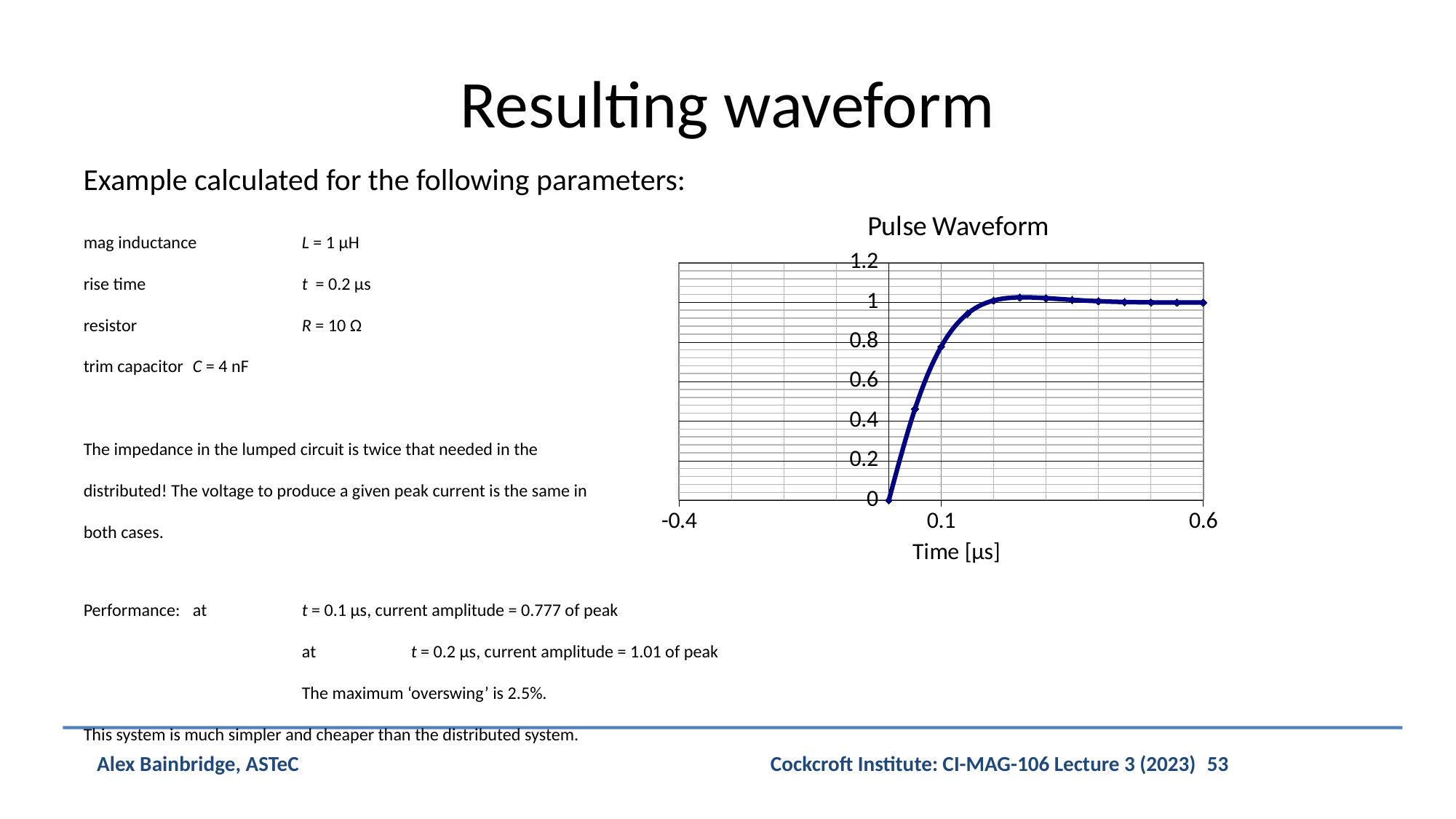
In the Pulse Waveform chart, is the value at 0.6 μs greater or less than 1.2? less What is the title of the chart on the slide? Pulse Waveform What is the highest tick value shown on the y axis of the Pulse Waveform chart? 1.2 In the Pulse Waveform chart, does the curve rise or fall between time 0 and 0.1 μs? rise In the Pulse Waveform chart, is the value at 0.1 μs greater or less than 0.6? greater What is the lowest tick value shown on the x axis of the Pulse Waveform chart? -0.4 What kind of chart is the Pulse Waveform chart? line chart In the Pulse Waveform chart, is the value at 0.6 μs greater or less than 0.8? greater In the Pulse Waveform chart, what is the value of the curve at its starting point at time 0? 0 How many data series are plotted in the Pulse Waveform chart? 1 What is the label of the x axis of the Pulse Waveform chart? Time [μs]